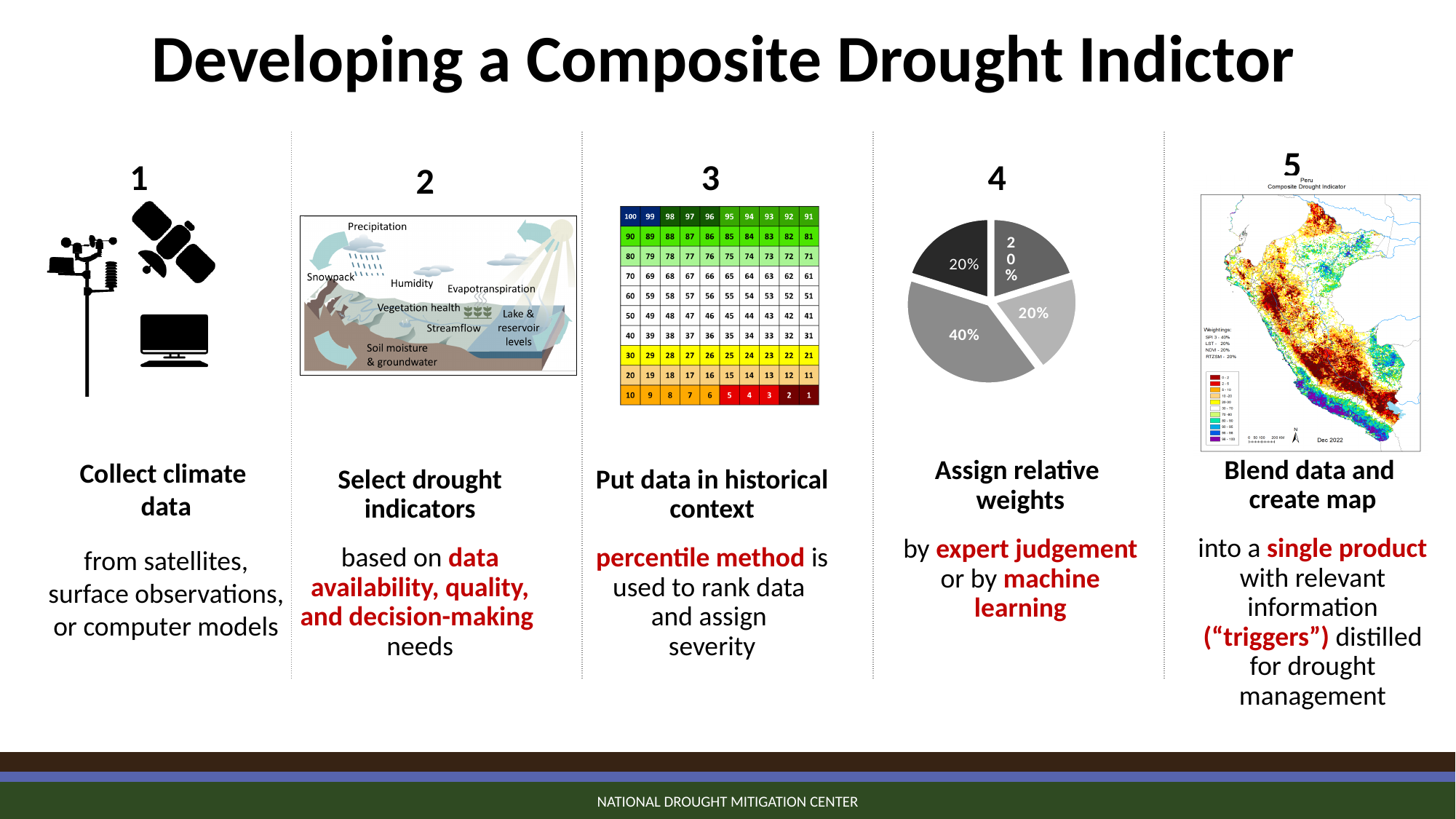
In the pie chart under step 4, which is larger: the medium-grey slice at the bottom left or the light-grey slice on the right? the medium-grey slice at the bottom left In the pie chart under step 4, what share is shown on the medium-grey slice at the bottom left? 40% What kind of chart is shown under step 4, "Assign relative weights"? pie chart In the pie chart under step 4, do the labelled slice shares add up to 100%? yes How many slices does the pie chart under step 4 have? 4 In the pie chart under step 4, what is the difference between the largest slice and the light-grey slice on the right? 20% What colour scheme is used for the slices of the pie chart under step 4? shades of grey In the pie chart under step 4, how many slices are labelled 20%? 3 Does the pie chart under step 4 have a legend? no In the pie chart under step 4, what share is shown on the dark slice at the top left? 20% In the pie chart under step 4, what is the share of the largest slice? 40% In the pie chart under step 4, what share is shown on the light-grey slice on the right? 20%